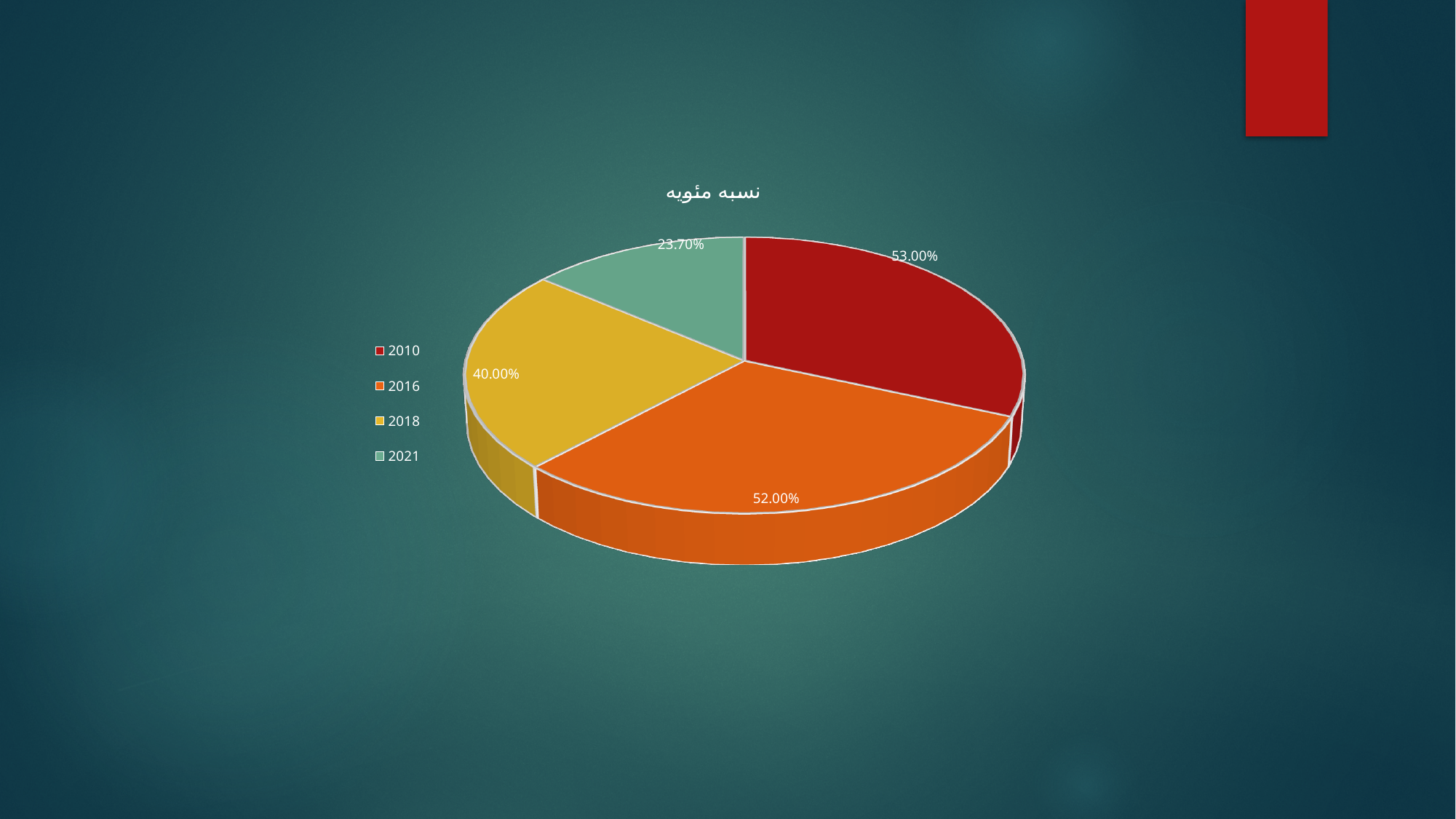
What value is shown for the 2016 slice of the pie chart? 52.00% Which is larger, the value for 2018 or the value for 2021? 2018 What is the difference between the values labelled for 2010 and 2018? 13.00% What type of chart is shown on the slide? Pie chart What is the difference between the values labelled for 2018 and 2021? 16.30% What value is shown for the 2010 slice of the pie chart? 53.00% What is the title of the chart? نسبه مئويه How many categories does the pie chart show? 4 What value is shown for the 2021 slice of the pie chart? 23.70% What value is shown for the 2018 slice of the pie chart? 40.00% Which category has the largest value label in the pie chart? 2010 Which category has the smallest slice in the pie chart? 2021